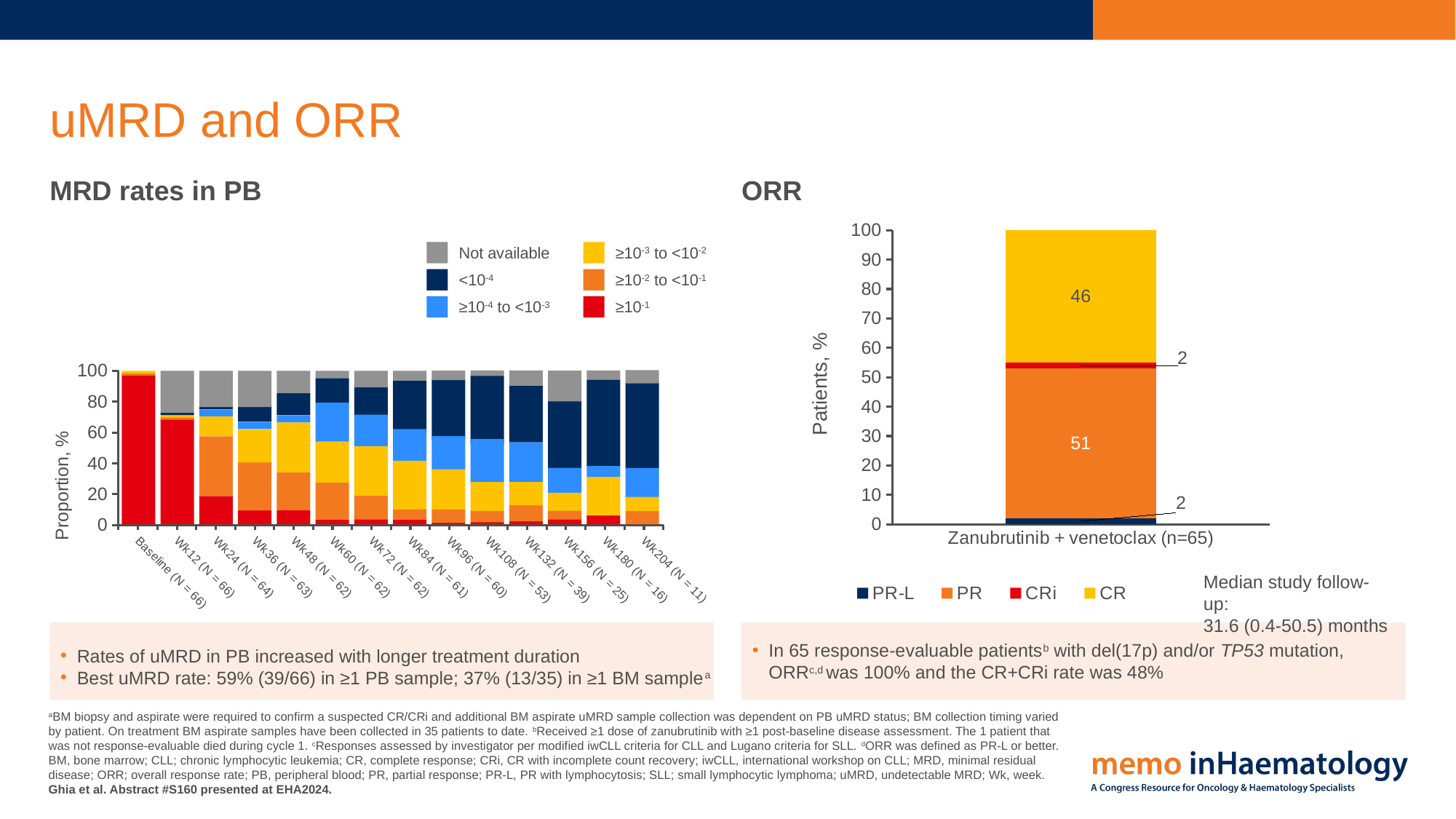
In the MRD rates in PB chart, is the ≥10⁻¹ proportion at Baseline greater or less than 80? greater In the ORR chart, what percentage of patients achieved CR? 46 What is the y-axis label of the ORR chart? Patients, % In the ORR chart, what is the difference between the PR and CR values? 5 What kind of chart is the MRD rates in PB chart? Stacked bar chart In the ORR chart, what is the value for CRi? 2 In the ORR chart, which is larger, the PR value or the CR value? PR In the ORR chart, which response category has the largest share of patients? PR How many series does the legend of the ORR chart list? 4 In the ORR chart, what percentage of patients achieved PR? 51 How many time points (categories) are shown on the x axis of the MRD rates in PB chart? 14 How many series does the legend of the MRD rates in PB chart list? 6